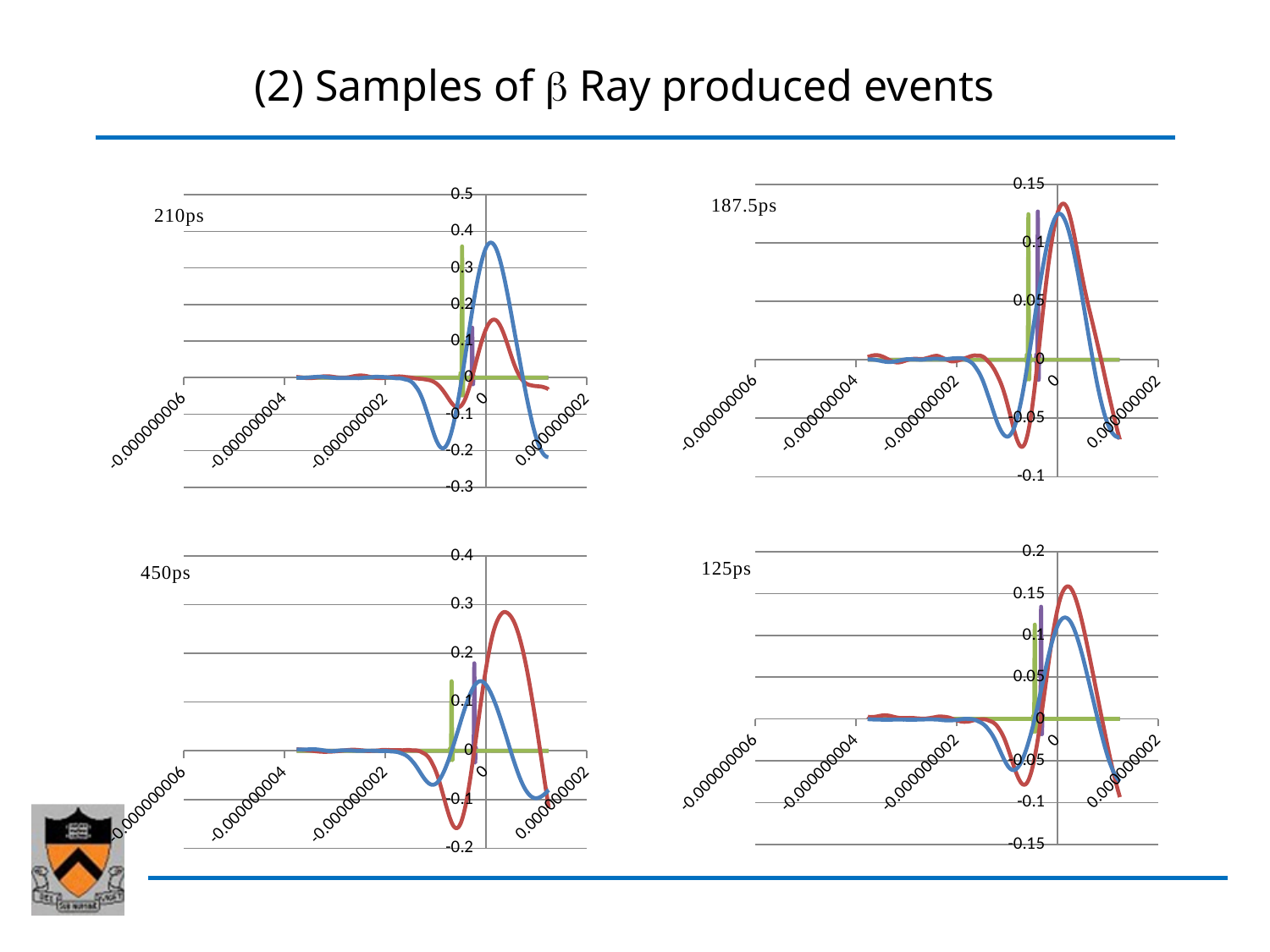
What is the highest value shown on the y axis of the 210ps chart? 0.5 In the 210ps chart, is the peak value of the red line greater or less than 0.2? less How many charts are shown on the slide? 4 What is the label shown on the top-right chart? 187.5ps What kind of chart is the 210ps chart? line chart In the 450ps chart, is the lowest value of the red line greater or less than -0.1? less In the 125ps chart, is the peak value of the red line greater or less than 0.1? greater In the 450ps chart, which line reaches the higher peak, the blue line or the red line? red In the 210ps chart, which line reaches the higher peak, the blue line or the red line? blue